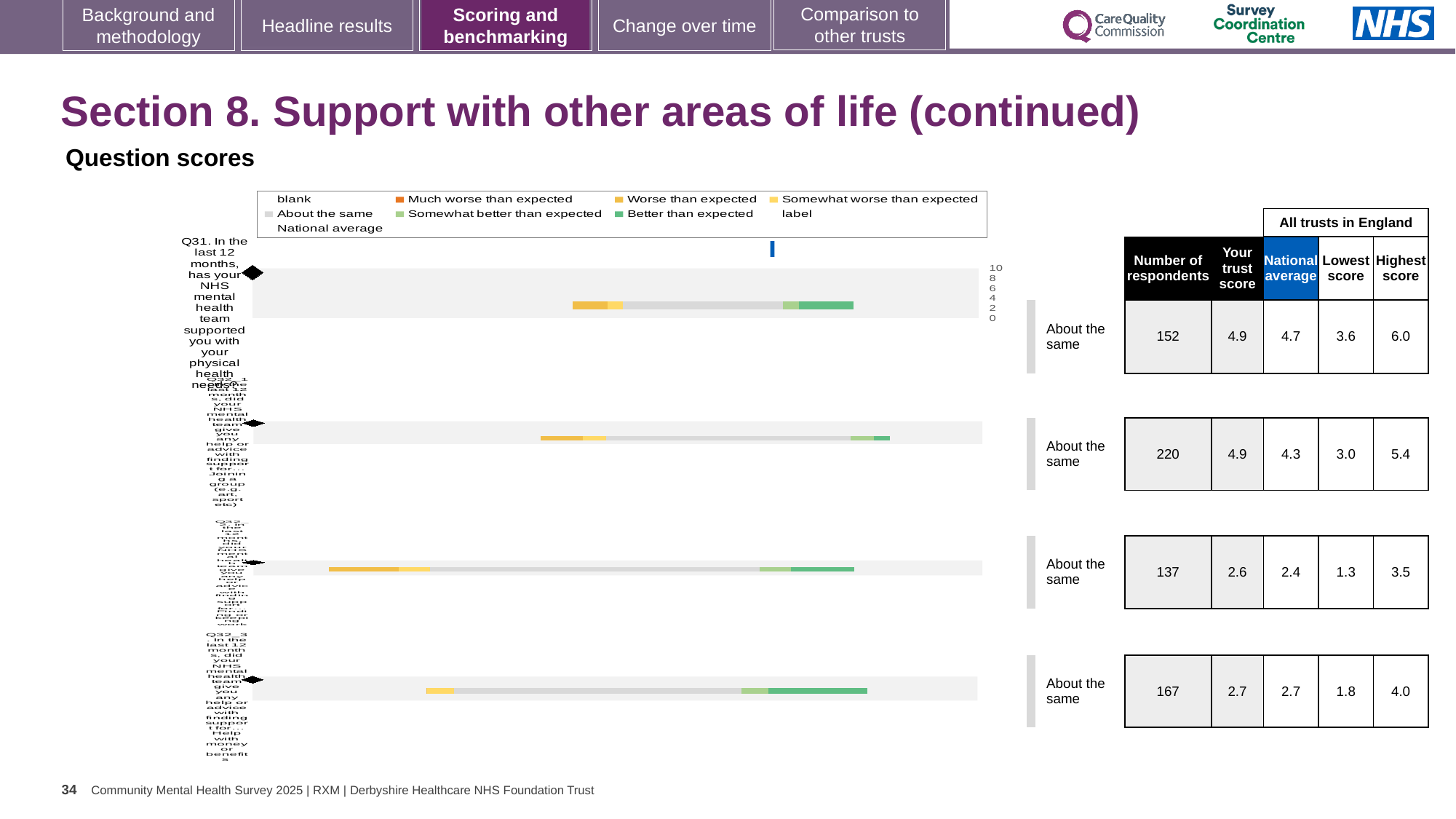
How many horizontal bars are plotted in the question scores chart? 4 What benchmark label is shown to the right of the bar for Q31 in the question scores chart? About the same How many entries does the legend of the question scores chart list? 9 In the question scores chart legend, which entry is shown in light grey? About the same How many of the four bars in the question scores chart are labelled 'About the same'? 4 What is the first question label shown on the question scores chart? Q31. In the last 12 months, has your NHS mental health team supported you with your physical health needs? In the question scores chart legend, which entry is shown in orange? Much worse than expected What kind of chart is shown under 'Question scores'? bar chart